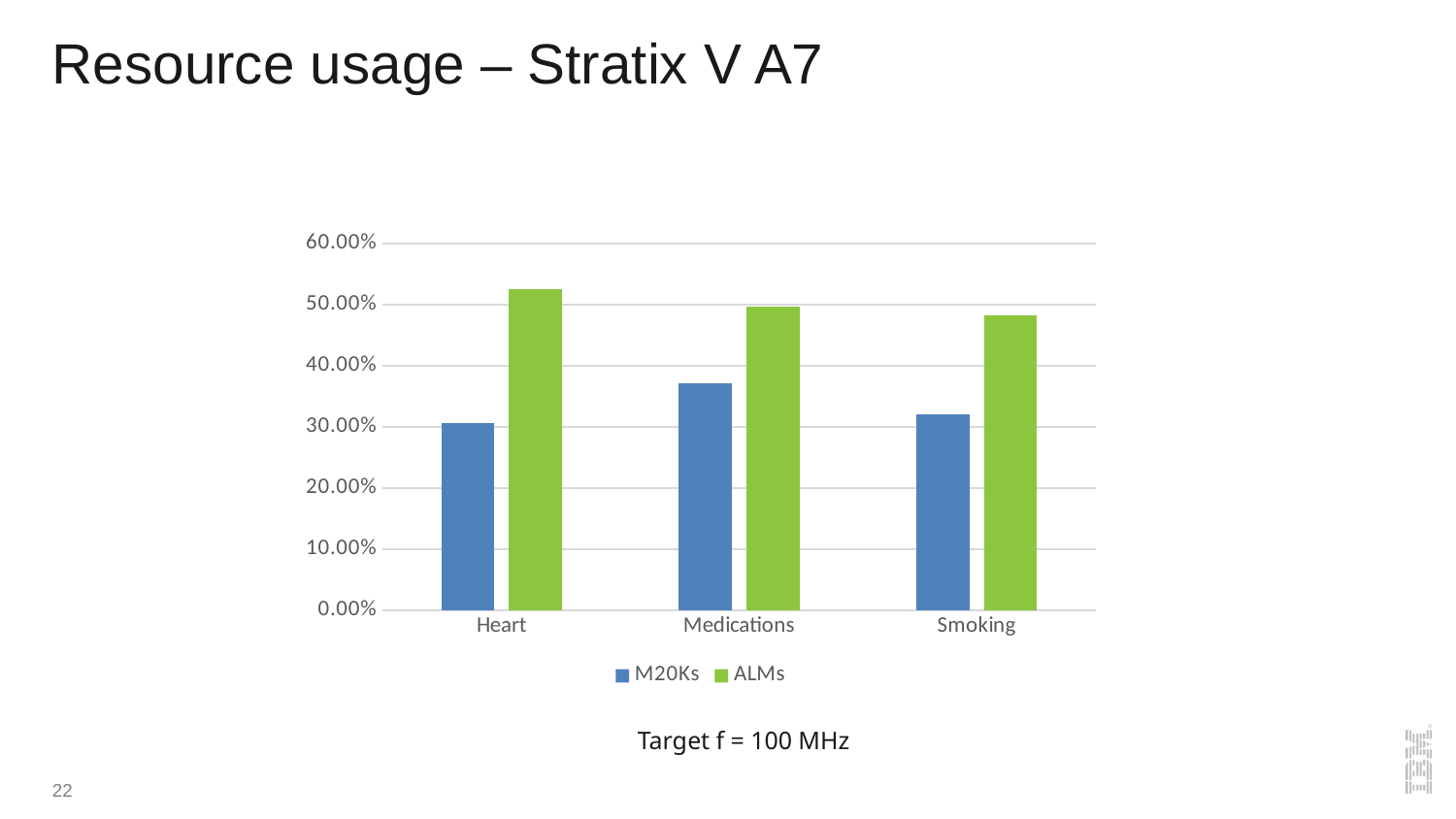
Which category has the highest M20Ks value? Medications What is the title of the slide containing the chart? Resource usage – Stratix V A7 How many categories are shown on the x axis? 3 Which series does the legend list first? M20Ks Is the M20Ks value for Medications greater or less than 40.00%? less For Heart, which series has the larger value, M20Ks or ALMs? ALMs How many series does the legend list? 2 Which category has the highest ALMs value? Heart What kind of chart is shown on the slide? bar chart Is the ALMs value for Heart greater or less than 50.00%? greater Is the ALMs value for Smoking greater or less than 50.00%? less